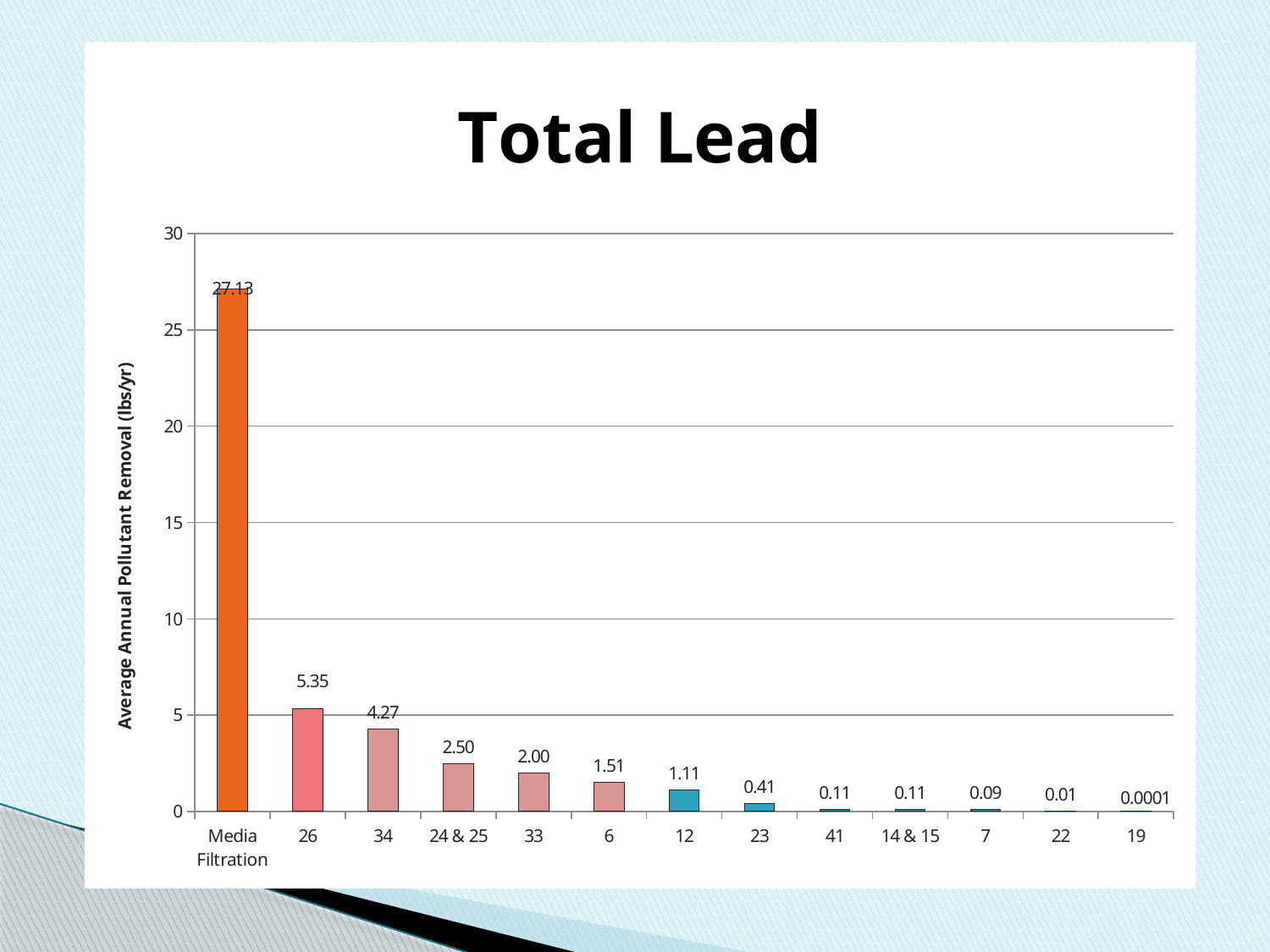
What is the value for category 19? 0.0001 Is the value for Media Filtration greater or less than 25? greater What is the label of the y axis? Average Annual Pollutant Removal (lbs/yr) What is the difference between the values for category 26 and category 34? 1.08 Which has a larger value, category 33 or category 6? 33 Which category has the highest value? Media Filtration How many categories are shown on the x axis? 13 What is the value for Media Filtration? 27.13 What is the value for category 24 & 25? 2.50 What is the value for category 26? 5.35 What kind of chart is shown on the slide? bar chart Which category has the lowest value? 19